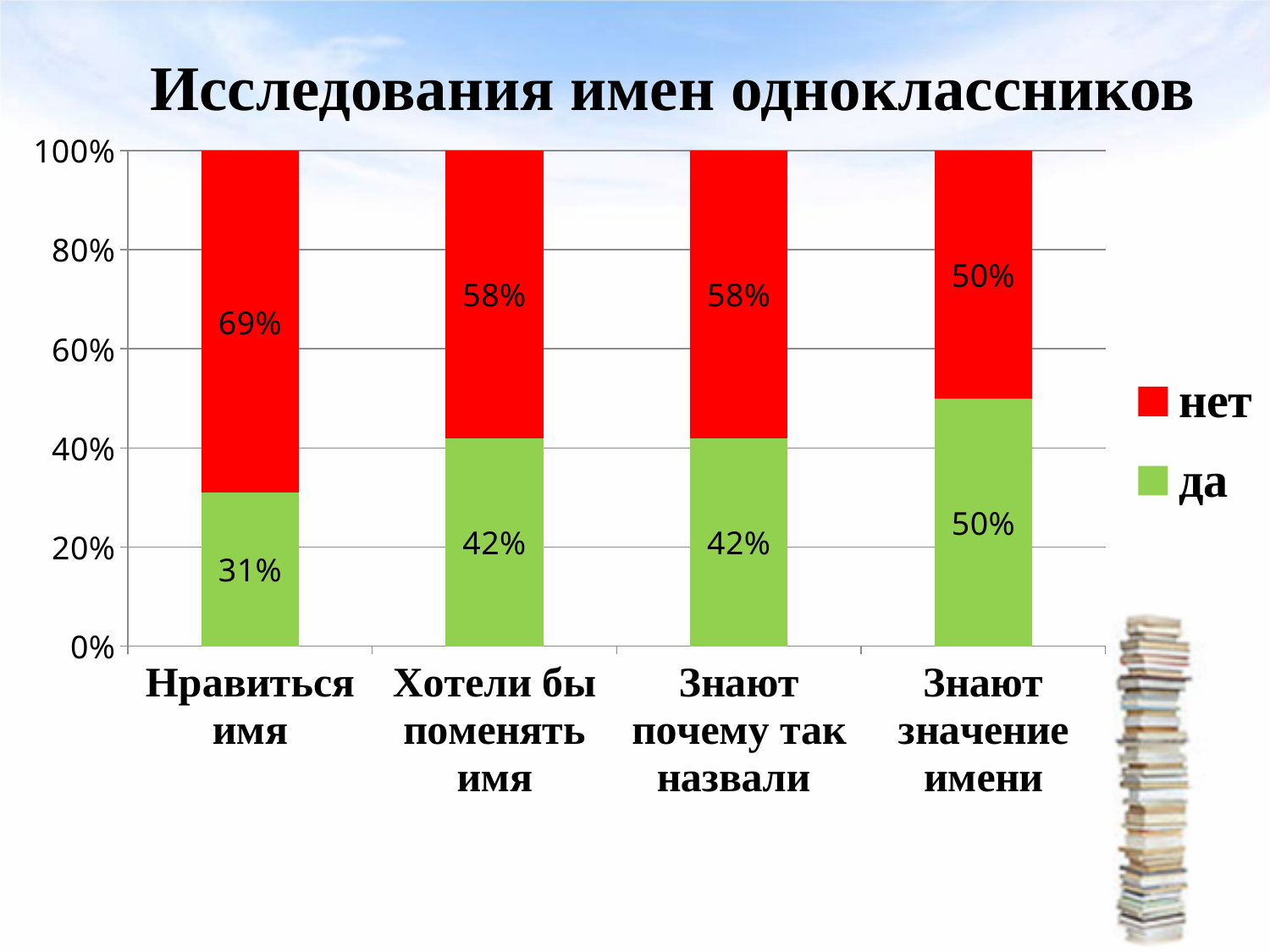
Which is larger for "Знают почему так назвали": "да" or "нет"? нет What is the value of "да" for "Хотели бы поменять имя"? 42% Which category has the highest value for "нет"? Нравиться имя How many series does the legend list? 2 What is the title of the chart? Исследования имен одноклассников What is the value of "нет" for "Нравиться имя"? 69% How many categories are shown on the x axis? 4 What is the difference between "нет" and "да" for "Нравиться имя"? 38% What is the value of "нет" for "Знают значение имени"? 50% Which category has the lowest value for "да"? Нравиться имя What is the value of "да" for "Нравиться имя"? 31% What kind of chart is shown on the slide? stacked bar chart